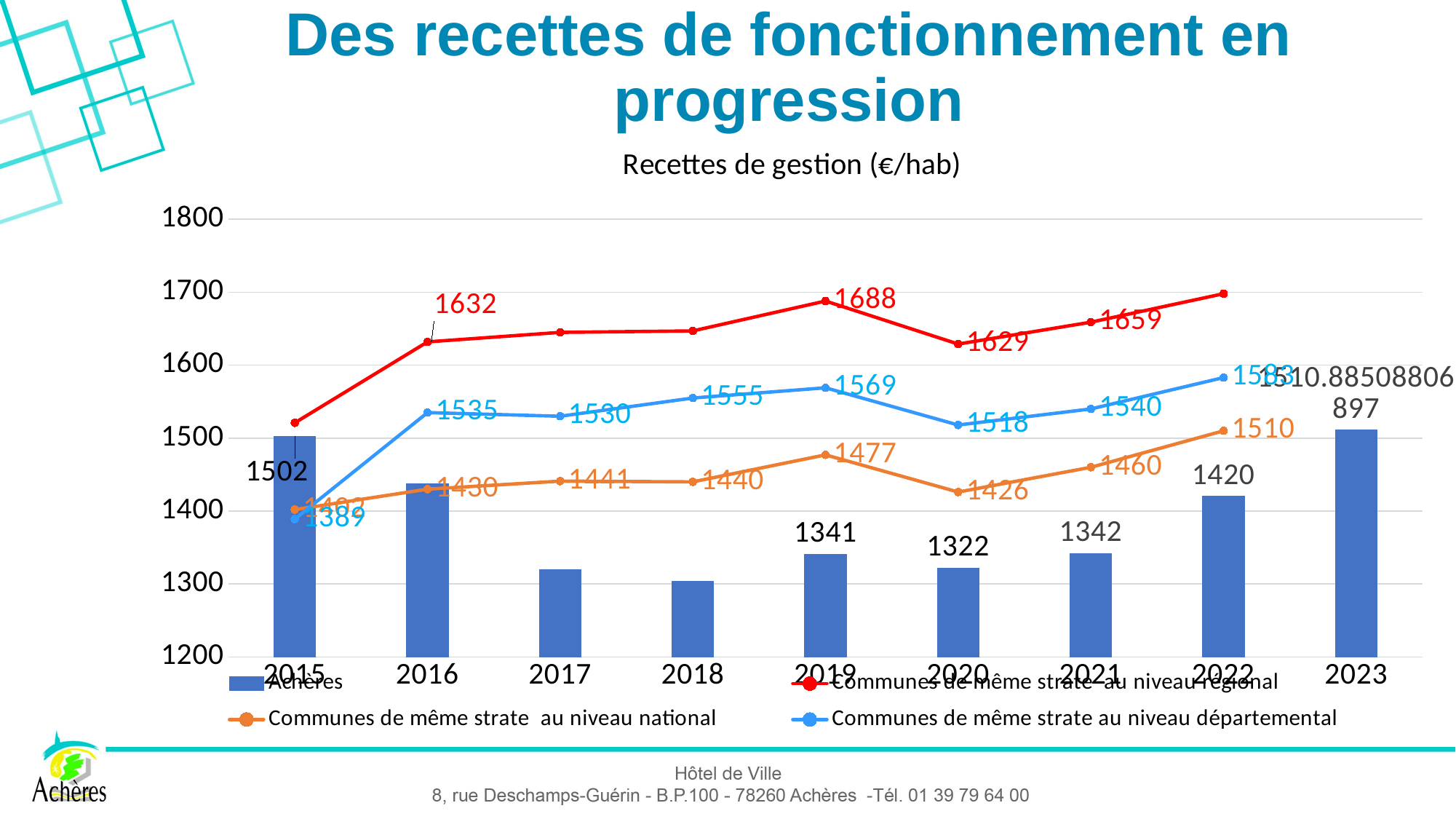
What is the value for 'Communes de même strate au niveau régional' in 2019? 1688 What is the value of the Achères bar for 2015? 1502 What is the value for 'Communes de même strate au niveau national' in 2022? 1510 What is the difference between the 2019 and 2020 values of the 'niveau régional' series? 59 Is the Achères bar for 2018 greater or less than 1400? less In which year is the 'Communes de même strate au niveau départemental' series at its lowest? 2015 In which year is the 'Communes de même strate au niveau national' series at its highest? 2022 How many series does the legend list? 4 Which year has the higher Achères bar, 2020 or 2021? 2021 How many years are shown on the x axis? 9 What is the value for 'Communes de même strate au niveau départemental' in 2020? 1518 What kind of chart is shown on the slide? A combined bar and line chart